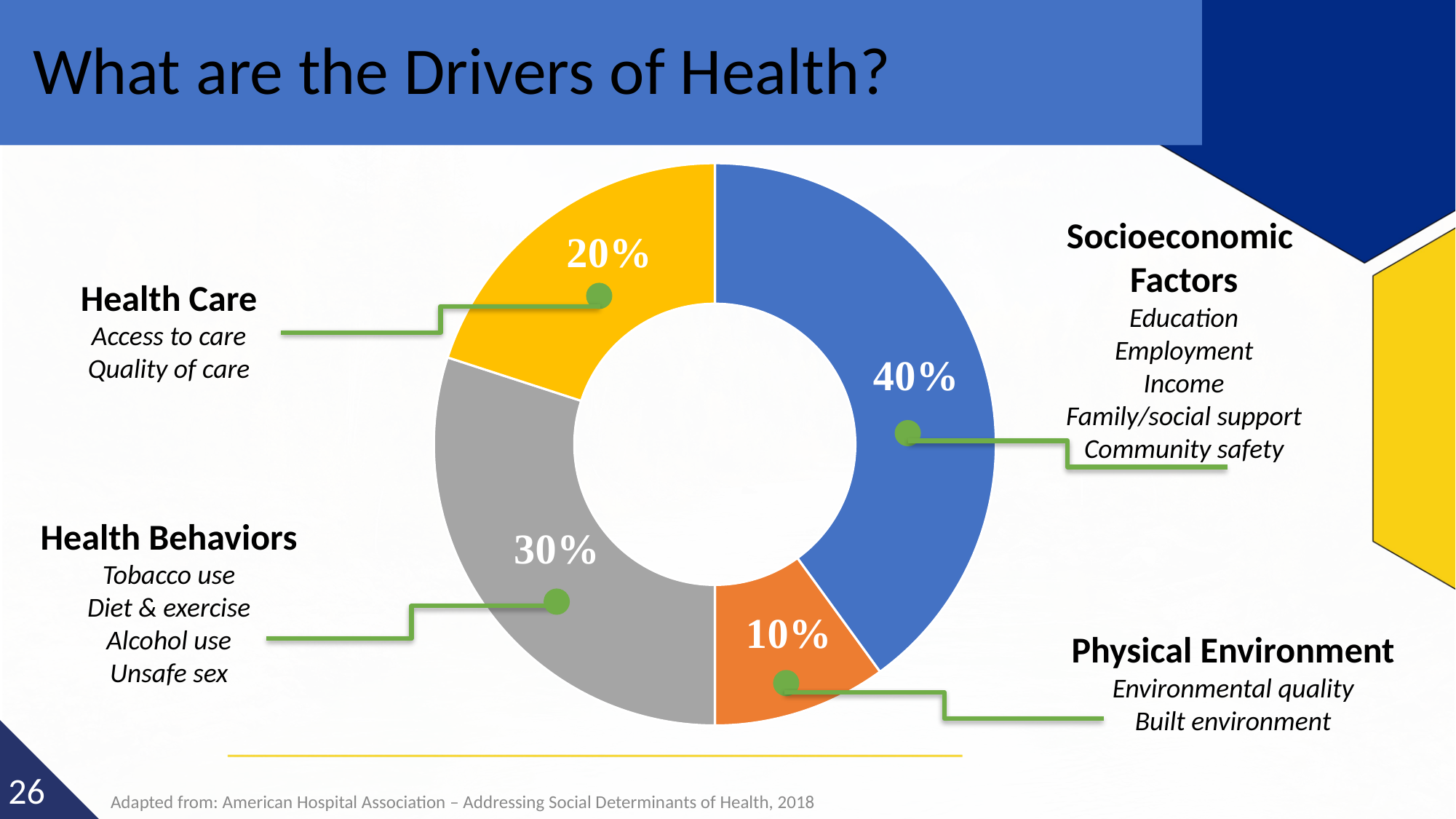
What colour is the Socioeconomic Factors segment of the chart? Blue What is the difference in percentage points between Health Behaviors and Physical Environment? 20% What share of the chart is attributed to Physical Environment? 10% What share of the chart is attributed to Socioeconomic Factors? 40% Which has a larger share, Health Behaviors or Health Care? Health Behaviors What kind of chart is shown on the slide? Doughnut (pie) chart Which driver of health has the smallest share in the chart? Physical Environment Which driver of health has the largest share in the chart? Socioeconomic Factors How many categories are shown in the chart? 4 What share of the chart is attributed to Health Behaviors? 30% What is the difference in percentage points between Socioeconomic Factors and Health Care? 20% What share of the chart is attributed to Health Care? 20%